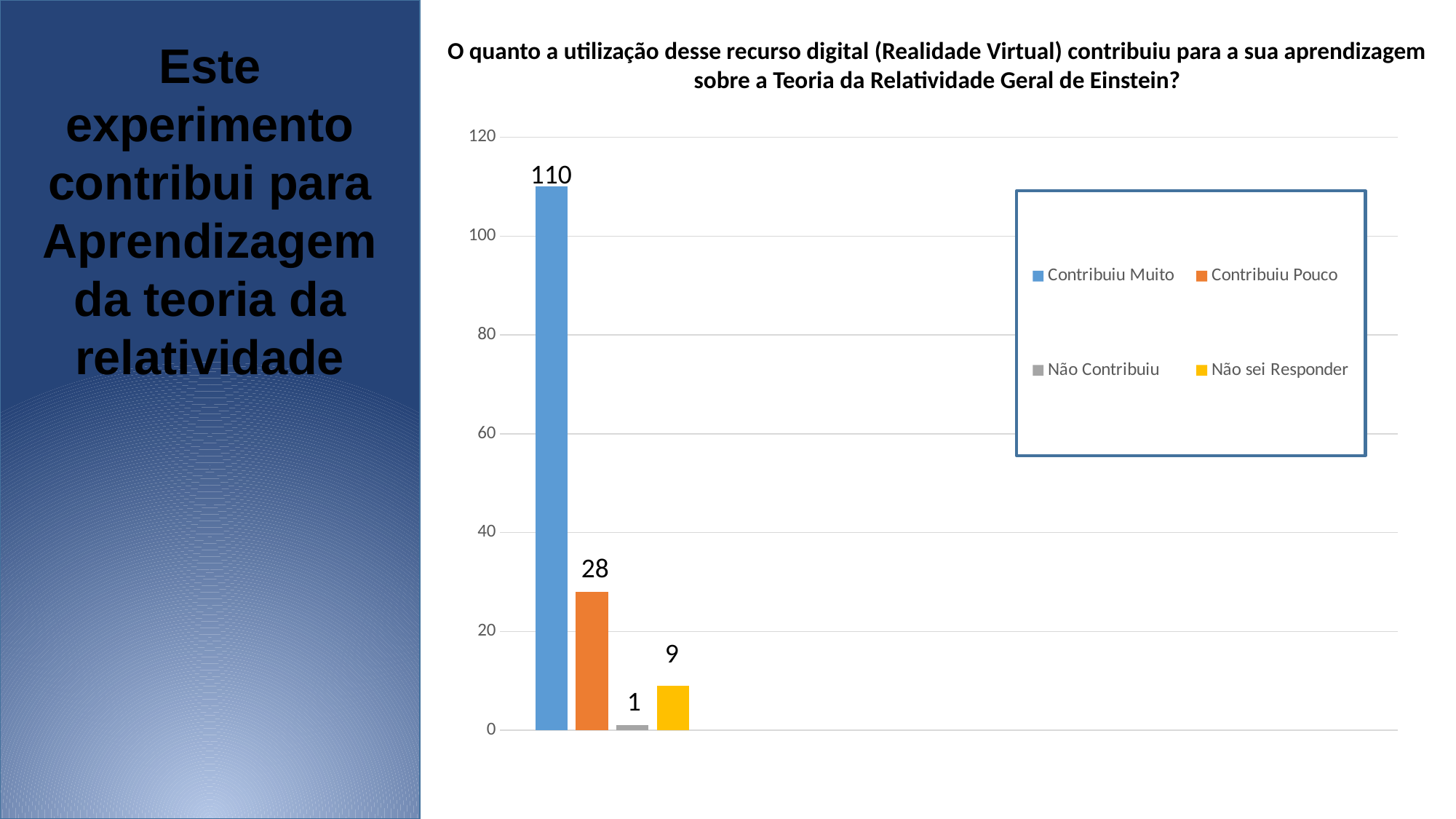
Which category has the lowest value? Não Contribuiu Which category has the highest value? Contribuiu Muito What is the value for Contribuiu Pouco? 28 What is the value for Contribuiu Muito? 110 What is the difference between the values for Contribuiu Muito and Contribuiu Pouco? 82 What colour is the bar for Não sei Responder? yellow Is the value for Contribuiu Muito greater or less than 100? greater What is the value for Não sei Responder? 9 Which is larger, the value for Contribuiu Pouco or the value for Não sei Responder? Contribuiu Pouco What is the value for Não Contribuiu? 1 What kind of chart is shown on the slide? bar chart How many series does the legend list? 4